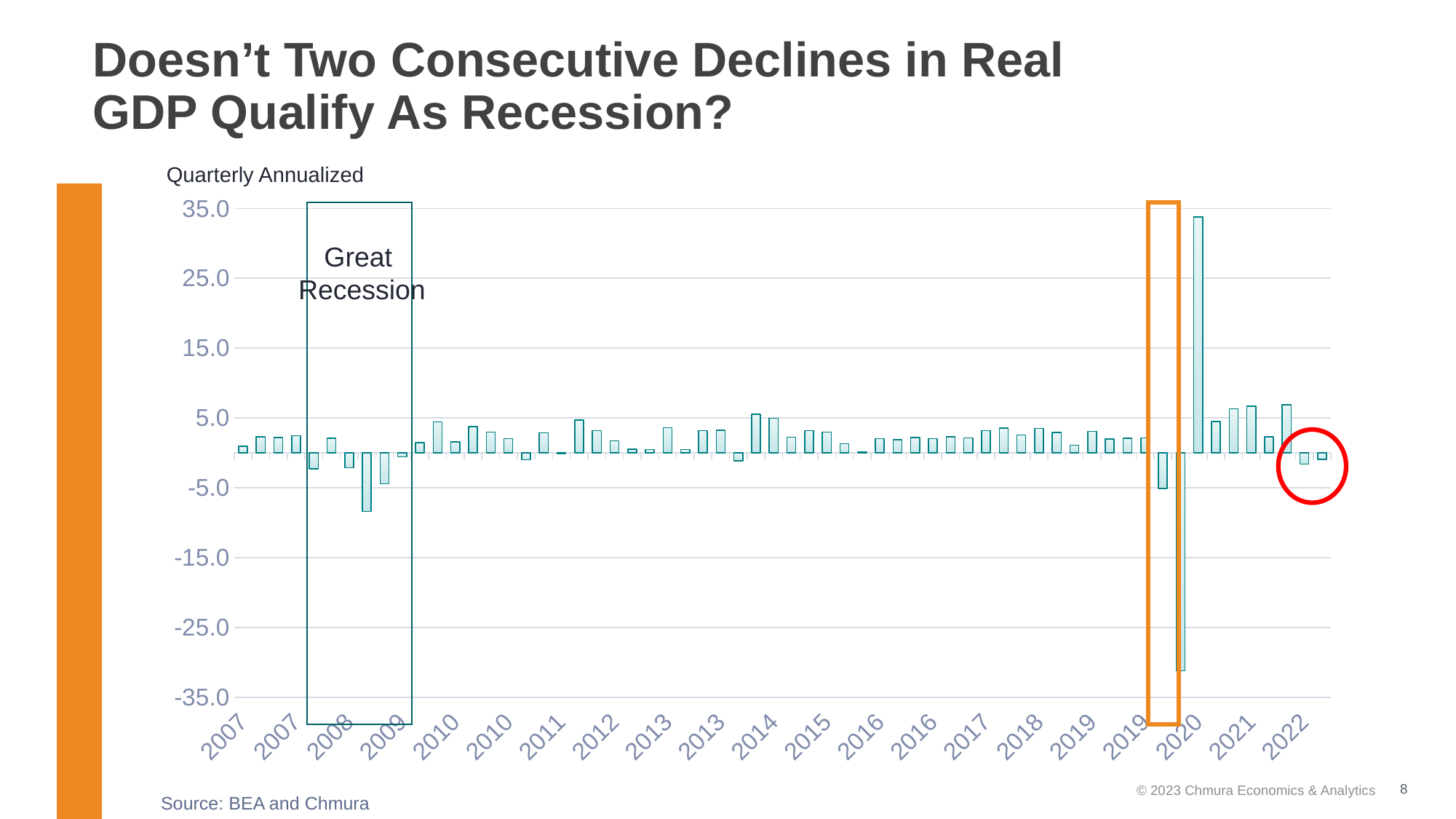
Is the value of the tallest bar in 2020 greater or less than 25.0? greater Is the value of the lowest bar in 2020 greater or less than -25.0? less In which year does the tallest bar on the chart appear? 2020 In which year does the lowest (most negative) bar on the chart appear? 2020 Which is taller: the tallest bar in 2020 or the tallest bar in 2021? 2020 Is the lowest bar within the Great Recession box greater or less than -5.0? less What label appears inside the outlined box over the 2008–2009 bars? Great Recession What subtitle is printed above the chart? Quarterly Annualized How many bars are enclosed by the red circle at the right end of the chart? 2 What kind of chart is shown on the slide? bar chart After the tall positive bar in 2020, do the bars generally rise or fall through 2022? fall